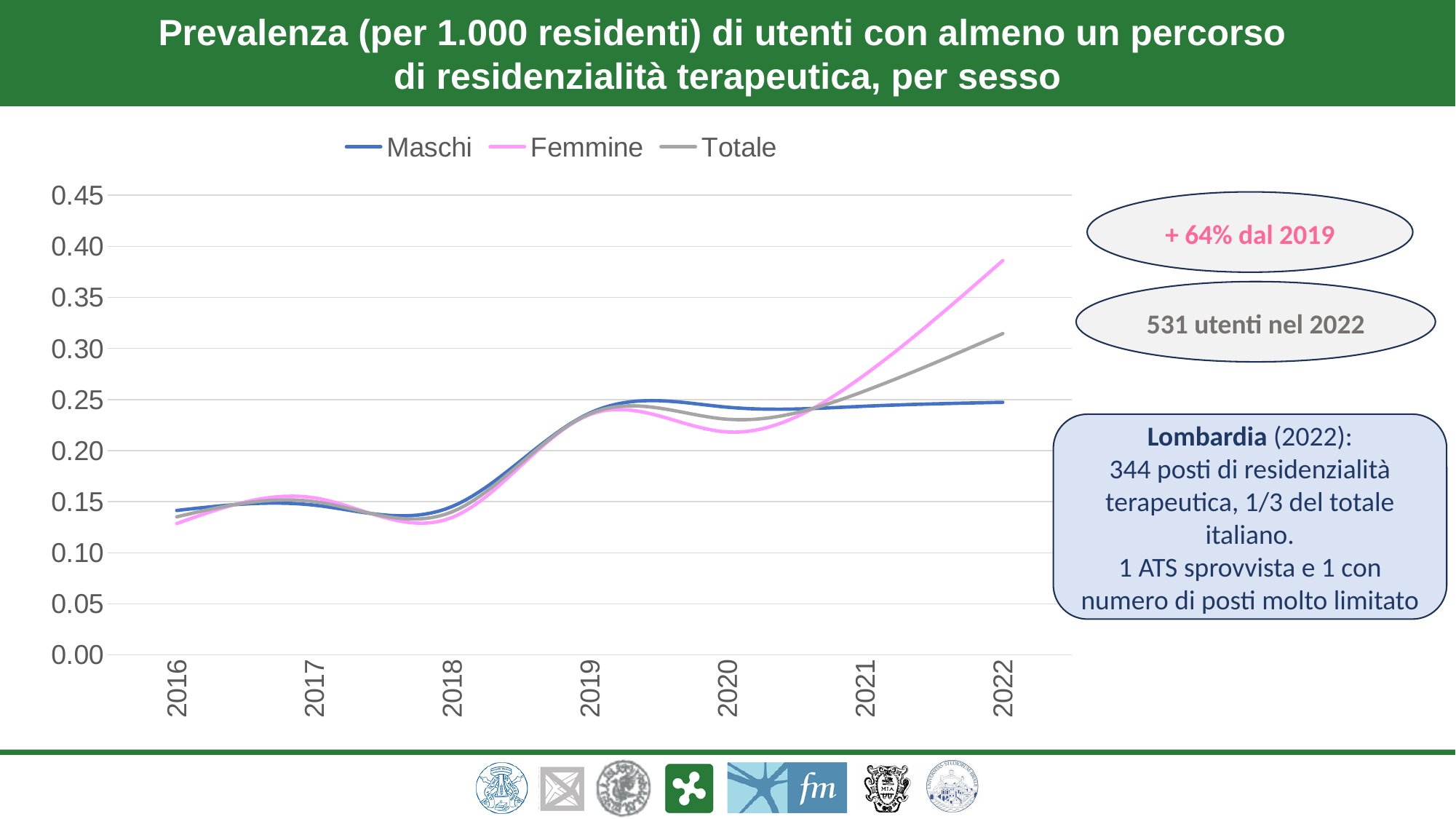
Does the Femmine line rise or fall between 2019 and 2022? rise Is the value for Totale in 2022 greater or less than 0.30? greater Which series has the lowest value in 2022? Maschi Which series has the highest value in 2022? Femmine How many years are shown on the x axis? 7 Which series is drawn in pink? Femmine In 2020, which is larger, the value for Maschi or the value for Femmine? Maschi What is the first year shown on the x axis? 2016 Is the value for Maschi in 2016 greater or less than 0.15? less What kind of chart is shown on the slide? line chart Is the value for Femmine in 2022 greater or less than 0.35? greater How many series does the legend list? 3